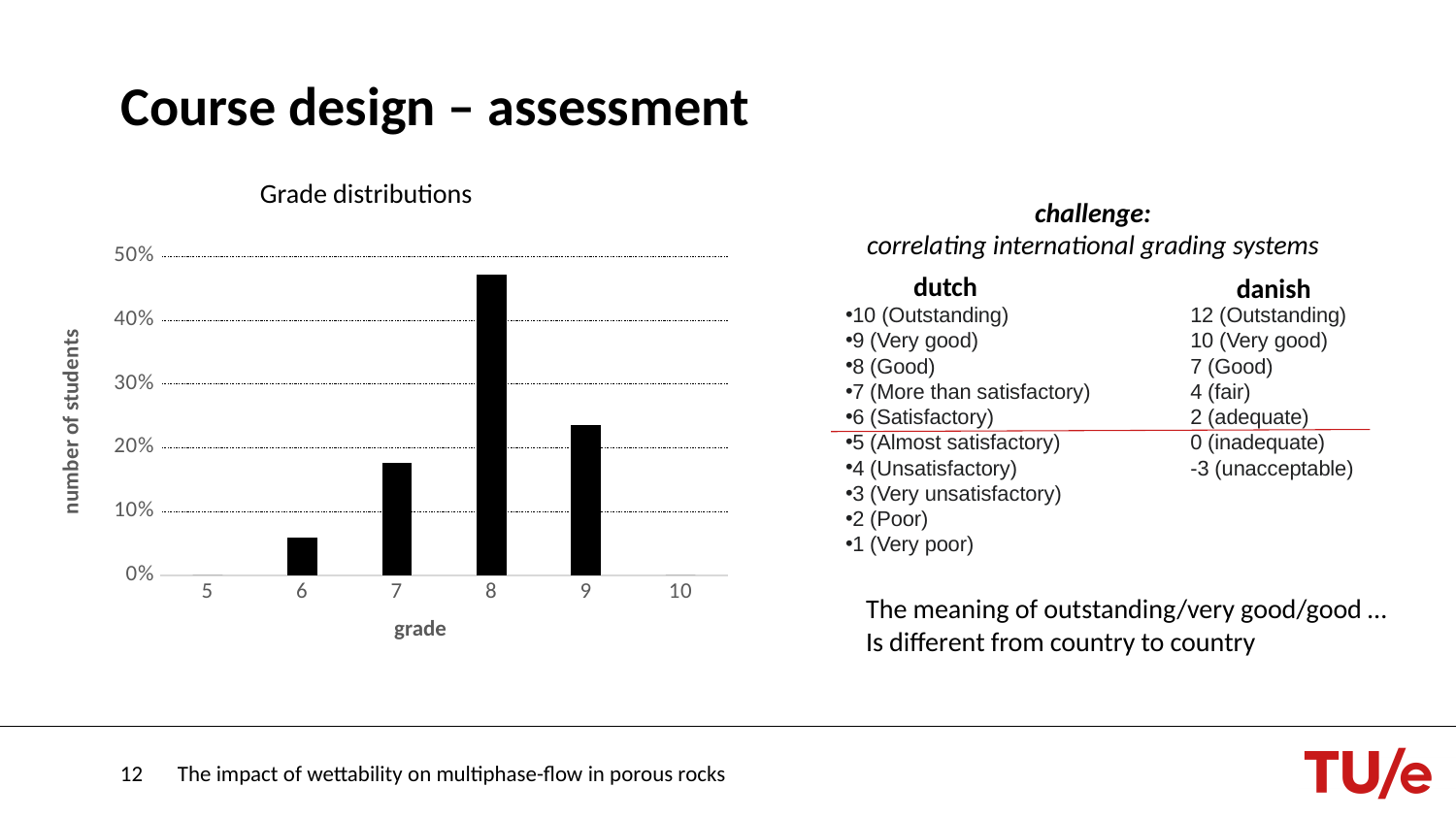
Is the value for grade 9 greater or less than 30%? less What kind of chart is shown on the slide? bar chart Is the value for grade 6 greater or less than 10%? less Which has a larger value, grade 8 or grade 9? grade 8 Is the value for grade 7 greater or less than 10%? greater Which grade has the tallest bar in the chart? 8 What is the title of the chart? Grade distributions How many grade categories are shown on the x axis of the chart? 6 Which has a larger value, grade 9 or grade 7? grade 9 What is the label of the vertical axis of the chart? number of students